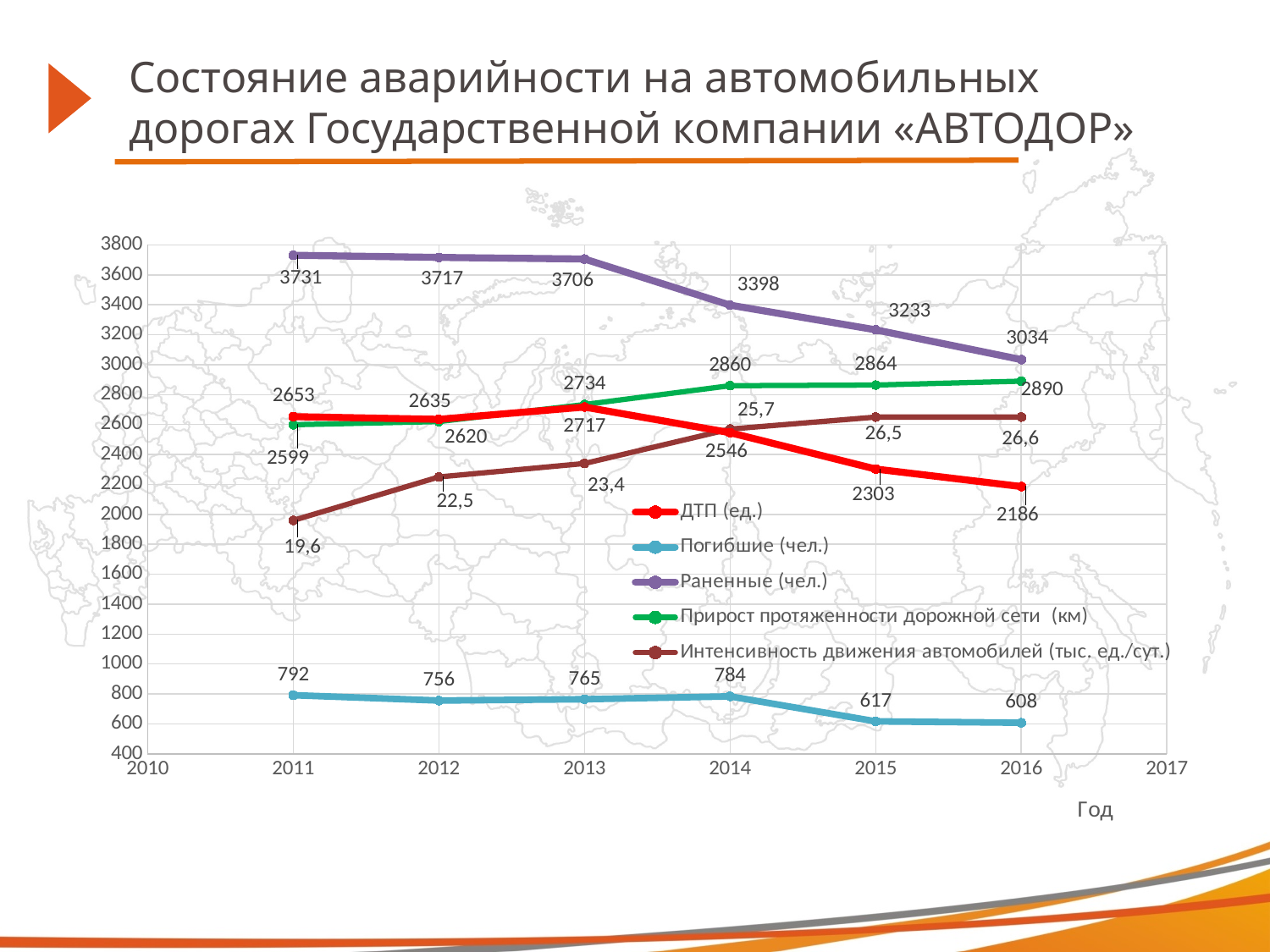
Which is larger: ДТП (ед.) in 2013 or in 2012? 2013 In which year is ДТП (ед.) highest? 2013 What is the value of Прирост протяженности дорожной сети (км) in 2013? 2734 What is the value of ДТП (ед.) in 2016? 2186 What is the value of Интенсивность движения автомобилей (тыс. ед./сут.) in 2011? 19,6 How many series does the legend list? 5 Does Раненные (чел.) rise or fall from 2011 to 2016? fall In which year is Погибшие (чел.) lowest? 2016 What is the value of Погибшие (чел.) in 2015? 617 What is the value of Раненные (чел.) in 2014? 3398 In which year is Раненные (чел.) highest? 2011 What is the difference between Раненные (чел.) in 2011 and in 2016? 697